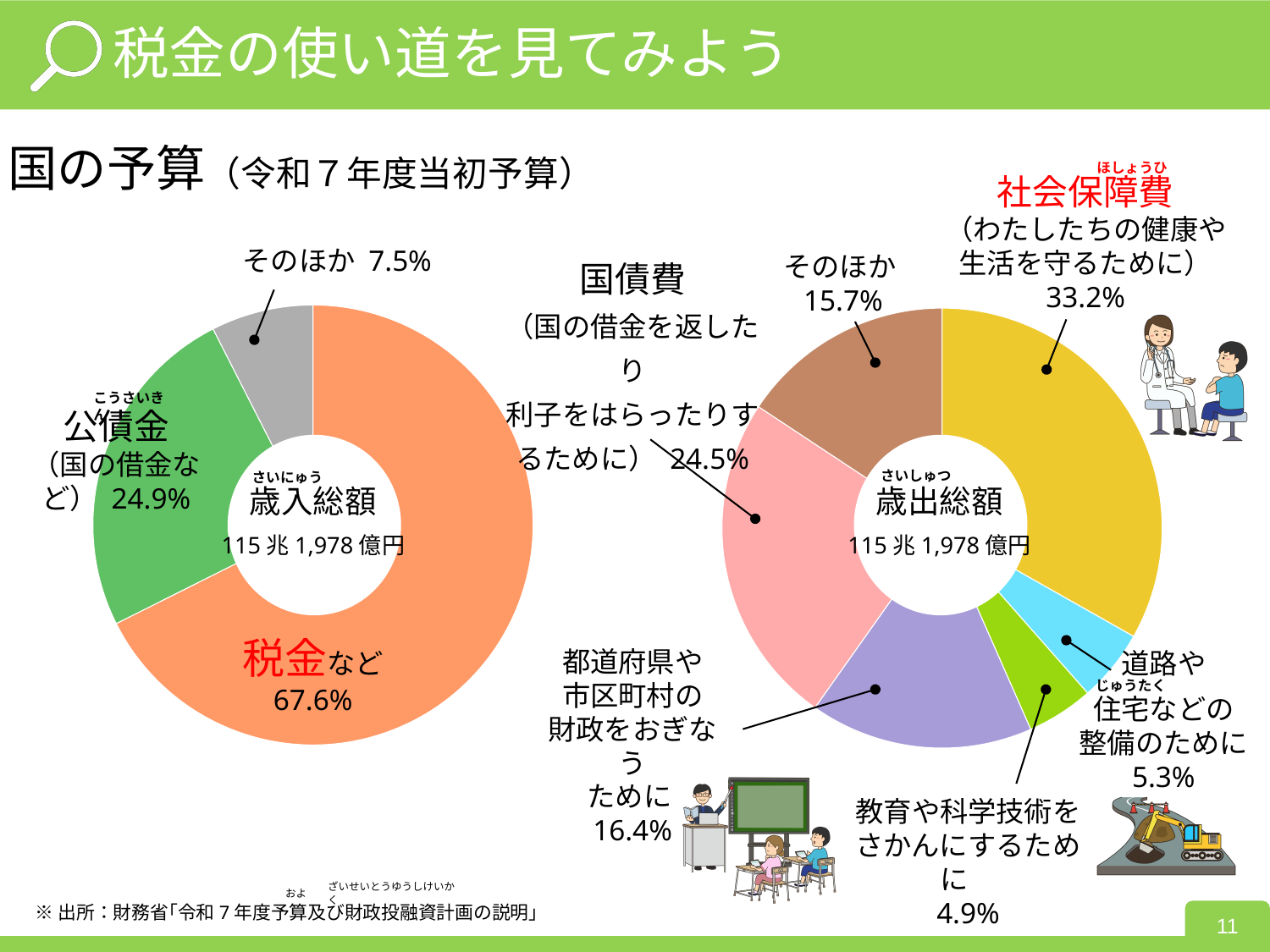
左の「歳入総額」のグラフで、最も割合が大きい項目はどれですか？ 税金など 右の「歳出総額」のグラフで、「国債費」の割合は何%ですか？ 24.5% 左の「歳入総額」のグラフで、「税金など」と「公債金」の割合の差は何ポイントですか？ 42.7ポイント 右の「歳出総額」のグラフには、いくつの項目がありますか？ 6 右の「歳出総額」のグラフで、「社会保障費」の割合は何%ですか？ 33.2% 左の「歳入総額」のグラフで、「税金など」の割合は何%ですか？ 67.6% このスライドのグラフはどの種類のグラフですか？ 円グラフ（ドーナツグラフ） 右の「歳出総額」のグラフで、「そのほか」と「都道府県や市区町村の財政をおぎなうために」では、どちらの割合が大きいですか？ 都道府県や市区町村の財政をおぎなうために 左の「歳入総額」のグラフで、「公債金」の割合は何%ですか？ 24.9% 左の「歳入総額」のグラフで、最も割合が小さい項目はどれですか？ そのほか 右の「歳出総額」のグラフで、最も割合が小さい項目はどれですか？ 教育や科学技術をさかんにするために 右の「歳出総額」のグラフで、「社会保障費」と「国債費」の割合の差は何ポイントですか？ 8.7ポイント